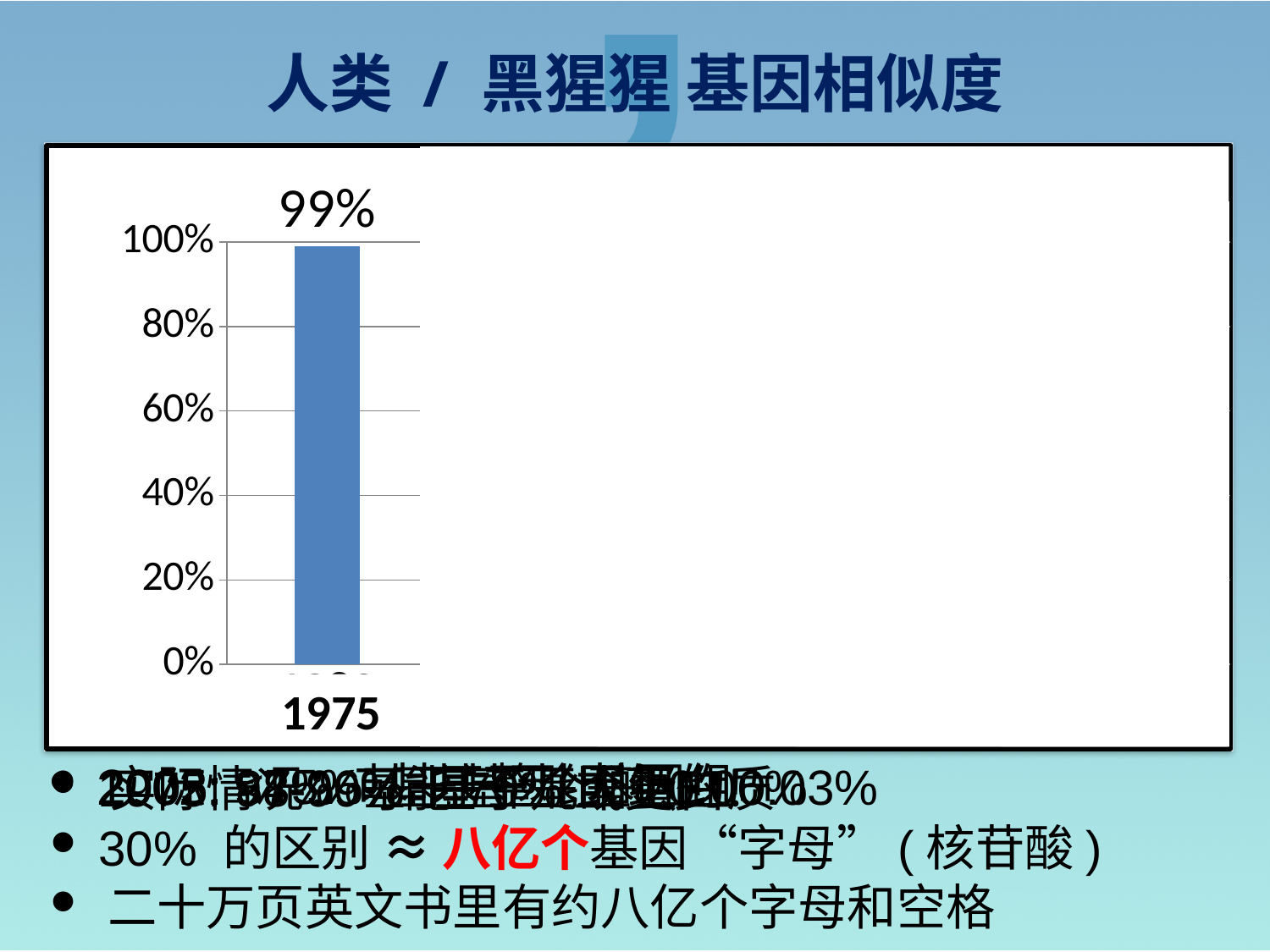
How many bars are plotted in the chart? 1 Is the value for 1975 greater or less than 60%? greater What value is shown for 1975 in the chart? 99% Is the value for 1975 greater or less than 80%? greater What type of chart is shown on the slide? bar chart What is the highest value shown on the vertical axis? 100% What is the category label shown under the bar? 1975